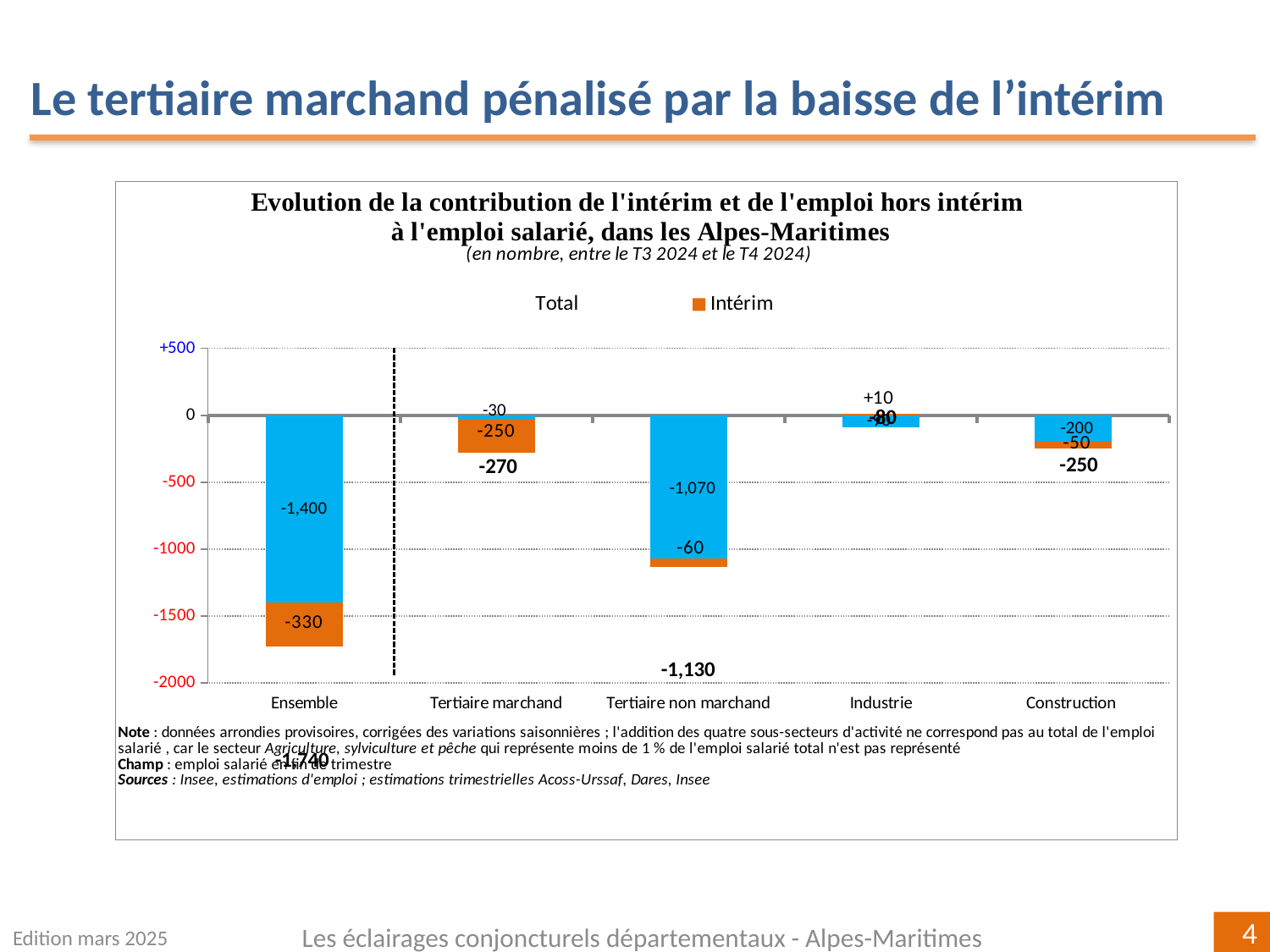
What is the Intérim value for Ensemble? -330 What is the Intérim value for Tertiaire marchand? -250 What is the difference between the Intérim values for Ensemble (-330) and Tertiaire marchand (-250)? 80 What kind of chart is shown on the slide? bar chart What is the total shown for the Tertiaire non marchand bar? -1,130 Which has the larger Intérim decline, Tertiaire marchand or Construction? Tertiaire marchand What is the total shown for the Tertiaire marchand bar? -270 Which category has the lowest (most negative) total bar? Ensemble What is the Intérim value for Construction? -50 What is the value of the blue (non-Intérim) segment for Tertiaire non marchand? -1,070 How many categories are shown along the x axis of the chart? 5 How many series does the chart's legend list? 2